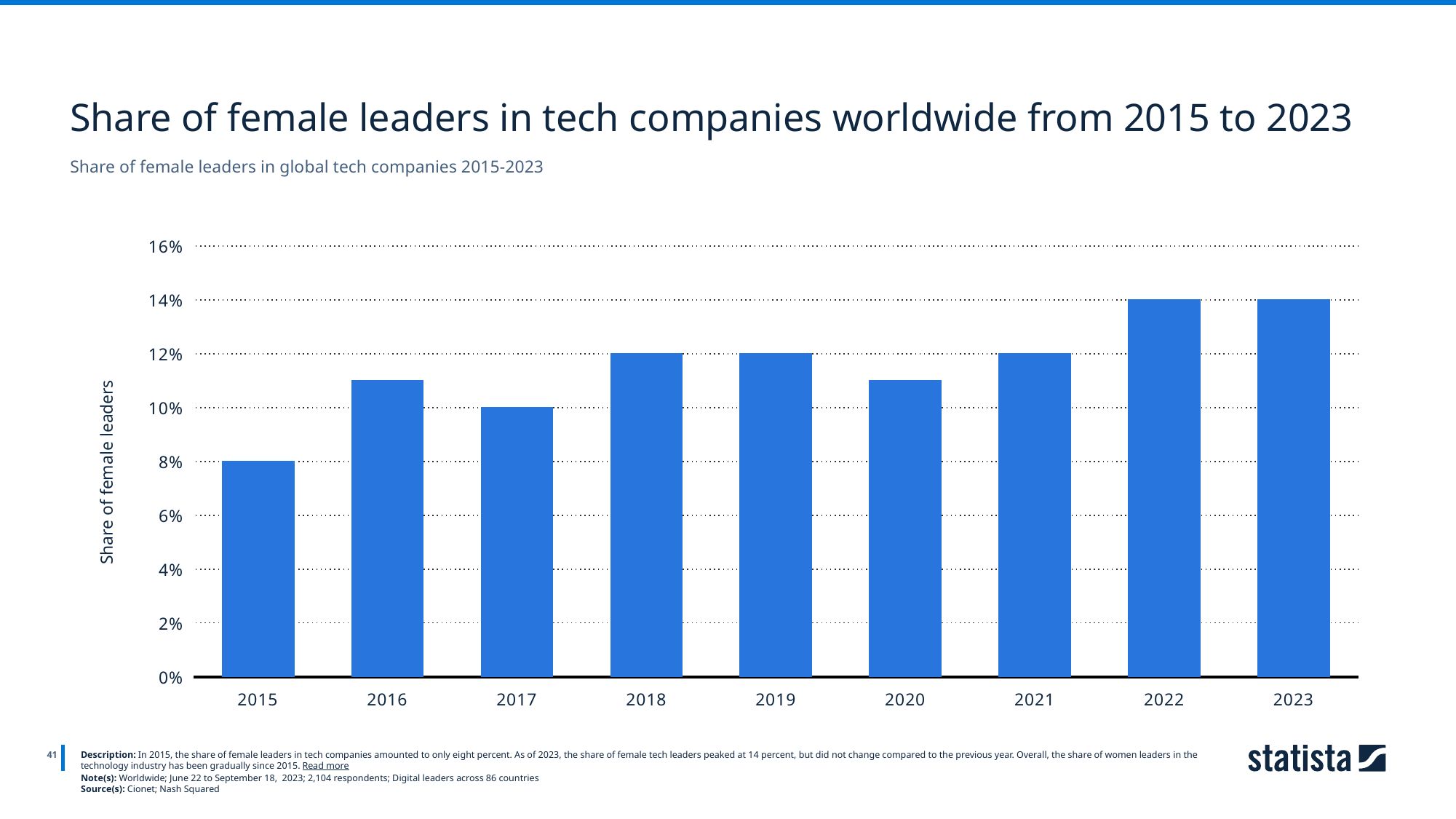
Is the share of female leaders in tech companies in 2016 greater or less than 10%? greater What is the share of female leaders in tech companies in 2015? 8% Which year has the lowest share of female leaders in tech companies? 2015 What is the share of female leaders in tech companies in 2023? 14% How many years are shown on the x axis of the chart? 9 Is the share of female leaders in tech companies in 2020 greater or less than 12%? less What is the share of female leaders in tech companies in 2018? 12% Which year has a higher share of female leaders in tech companies, 2018 or 2015? 2018 What is the share of female leaders in tech companies in 2017? 10% What is the label of the y axis of the chart? Share of female leaders What kind of chart is used to show the share of female leaders in tech companies? Bar chart By how many percentage points did the share of female leaders in tech companies increase from 2015 to 2023? 6 percentage points